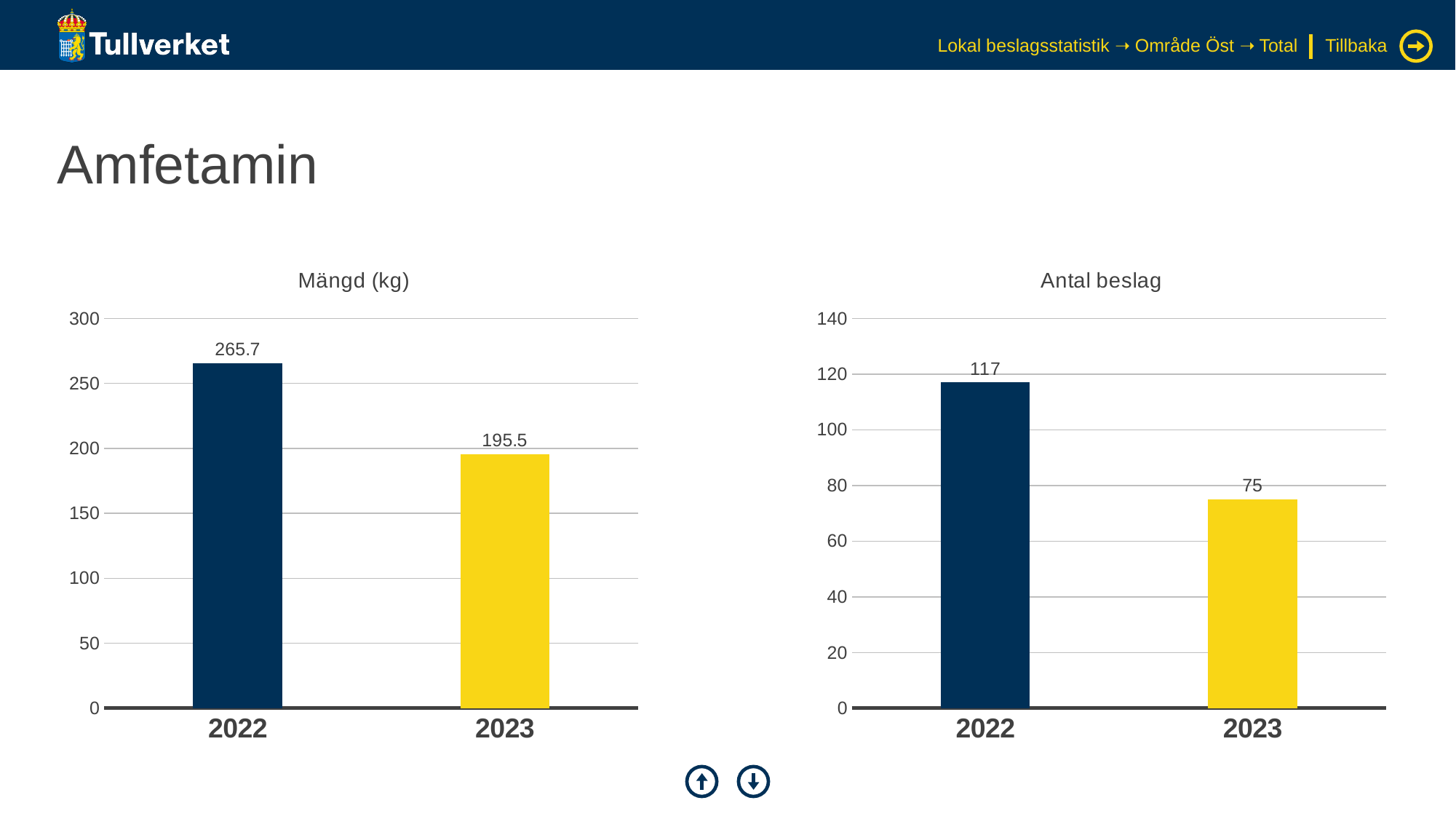
In the 'Antal beslag' chart, what is the value for 2022? 117 In the 'Antal beslag' chart, what is the value for 2023? 75 In the 'Antal beslag' chart, is the value for 2022 greater or less than 100? greater In the 'Mängd (kg)' chart, how many bars are plotted? 2 In the 'Mängd (kg)' chart, which year has the highest value? 2022 In the 'Mängd (kg)' chart, do the values rise or fall from 2022 to 2023? fall In the 'Antal beslag' chart, which year has the lowest value? 2023 In the 'Mängd (kg)' chart, what is the value for 2022? 265.7 What kind of chart is the 'Antal beslag' chart? bar chart In the 'Mängd (kg)' chart, what is the value for 2023? 195.5 In the 'Mängd (kg)' chart, what is the difference between the 2022 and 2023 values? 70.2 In the 'Antal beslag' chart, what is the difference between the 2022 and 2023 values? 42